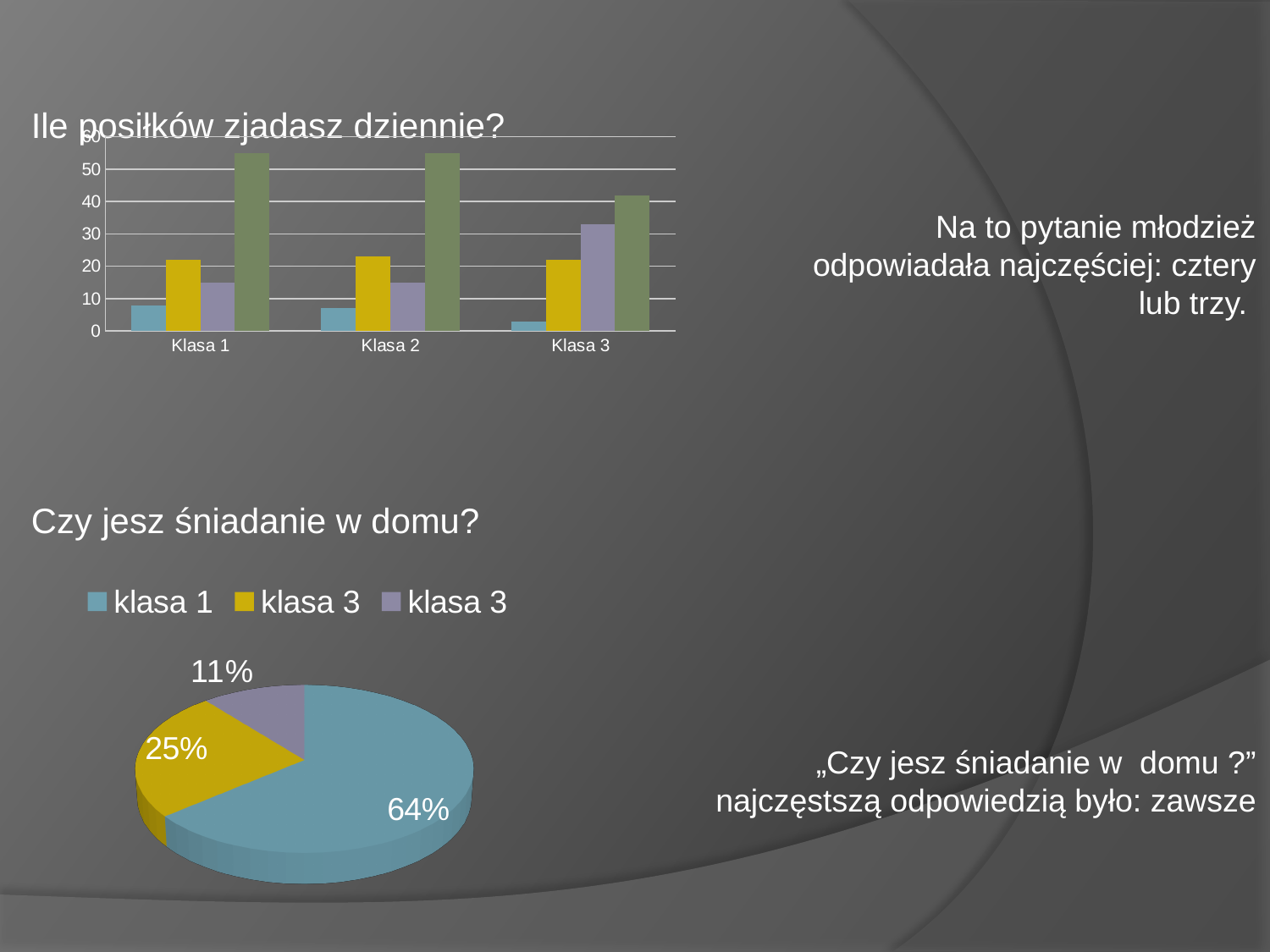
In the top bar chart "Ile posiłków zjadasz dziennie?", is the green bar for Klasa 1 greater or less than 50? greater What kind of chart is the bottom chart titled "Czy jesz śniadanie w domu?"? pie chart In the bottom pie chart "Czy jesz śniadanie w domu?", what share does the klasa 1 slice have? 64% In the bottom pie chart "Czy jesz śniadanie w domu?", what is the difference between the largest slice and the smallest slice? 53% In the top bar chart "Ile posiłków zjadasz dziennie?", is the teal bar for Klasa 3 greater or less than 10? less In the bottom pie chart "Czy jesz śniadanie w domu?", what is the value of the smallest slice? 11% In the top bar chart "Ile posiłków zjadasz dziennie?", which category has the tallest purple bar? Klasa 3 In the top bar chart "Ile posiłków zjadasz dziennie?", for Klasa 1, which is larger: the green bar or the teal bar? the green bar How many entries does the legend of the bottom pie chart "Czy jesz śniadanie w domu?" list? 3 What kind of chart is the top chart titled "Ile posiłków zjadasz dziennie?"? bar chart How many categories are shown on the x axis of the top bar chart "Ile posiłków zjadasz dziennie?"? 3 In the top bar chart "Ile posiłków zjadasz dziennie?", is the purple bar for Klasa 3 greater or less than 20? greater